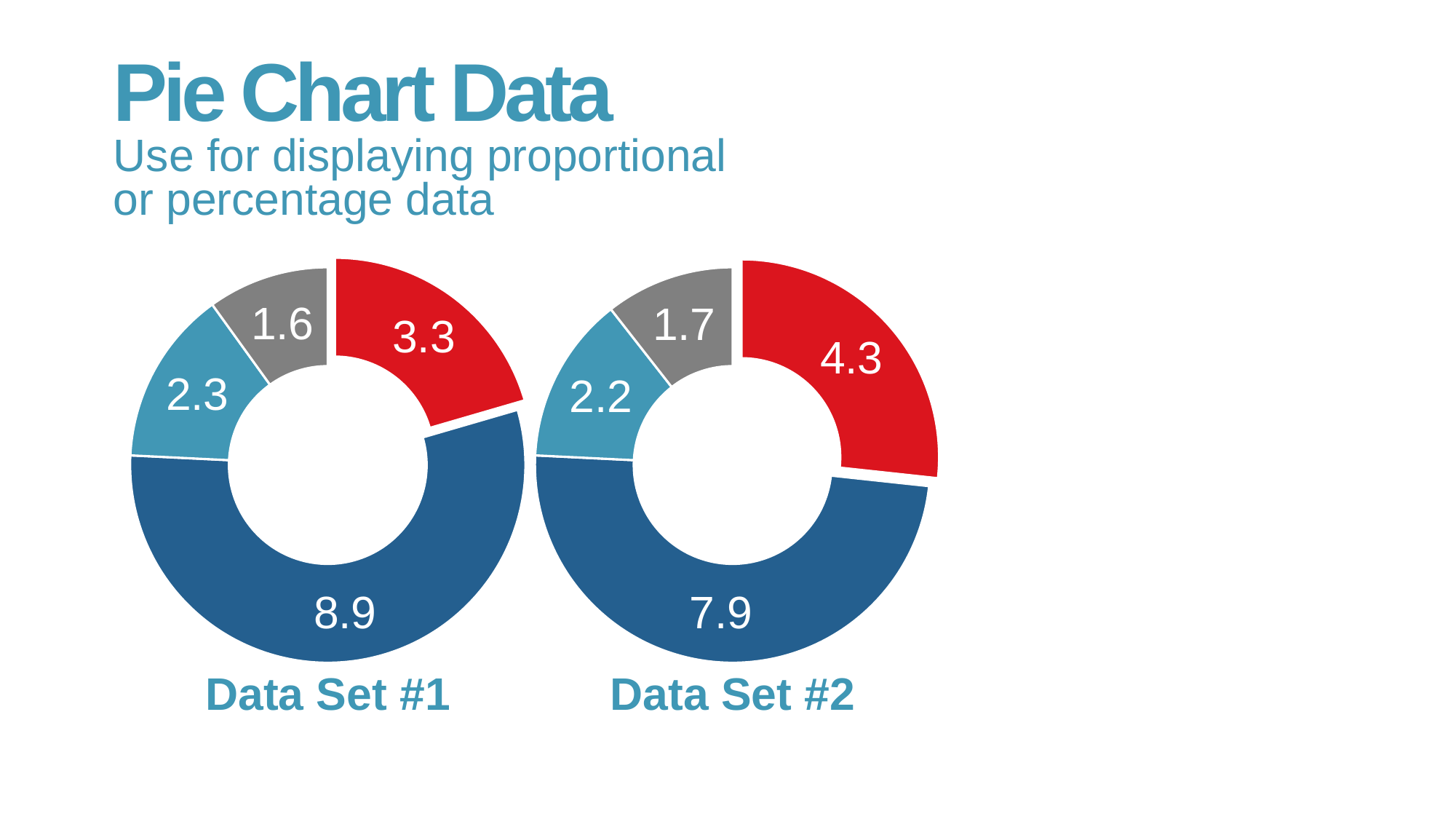
In the Data Set #2 chart, which slice has the smallest value? The grey slice (1.7) What is the total of all slices in the Data Set #1 chart? 16.1 In the Data Set #1 chart, which slice has the largest value? The dark blue slice (8.9) How many slices does the Data Set #1 chart have? 4 Which is larger: the dark blue slice in Data Set #1 or the dark blue slice in Data Set #2? Data Set #1 (8.9) What is the difference between the red slice in Data Set #2 and the red slice in Data Set #1? 1.0 In the Data Set #1 chart, what is the value of the grey slice? 1.6 In the Data Set #1 chart, what is the value of the red slice? 3.3 What kind of chart is used for Data Set #2? Pie chart (doughnut) In the Data Set #2 chart, what is the value of the light blue slice? 2.2 What is the title of the slide containing the two charts? Pie Chart Data In the Data Set #2 chart, what is the value of the dark blue slice? 7.9